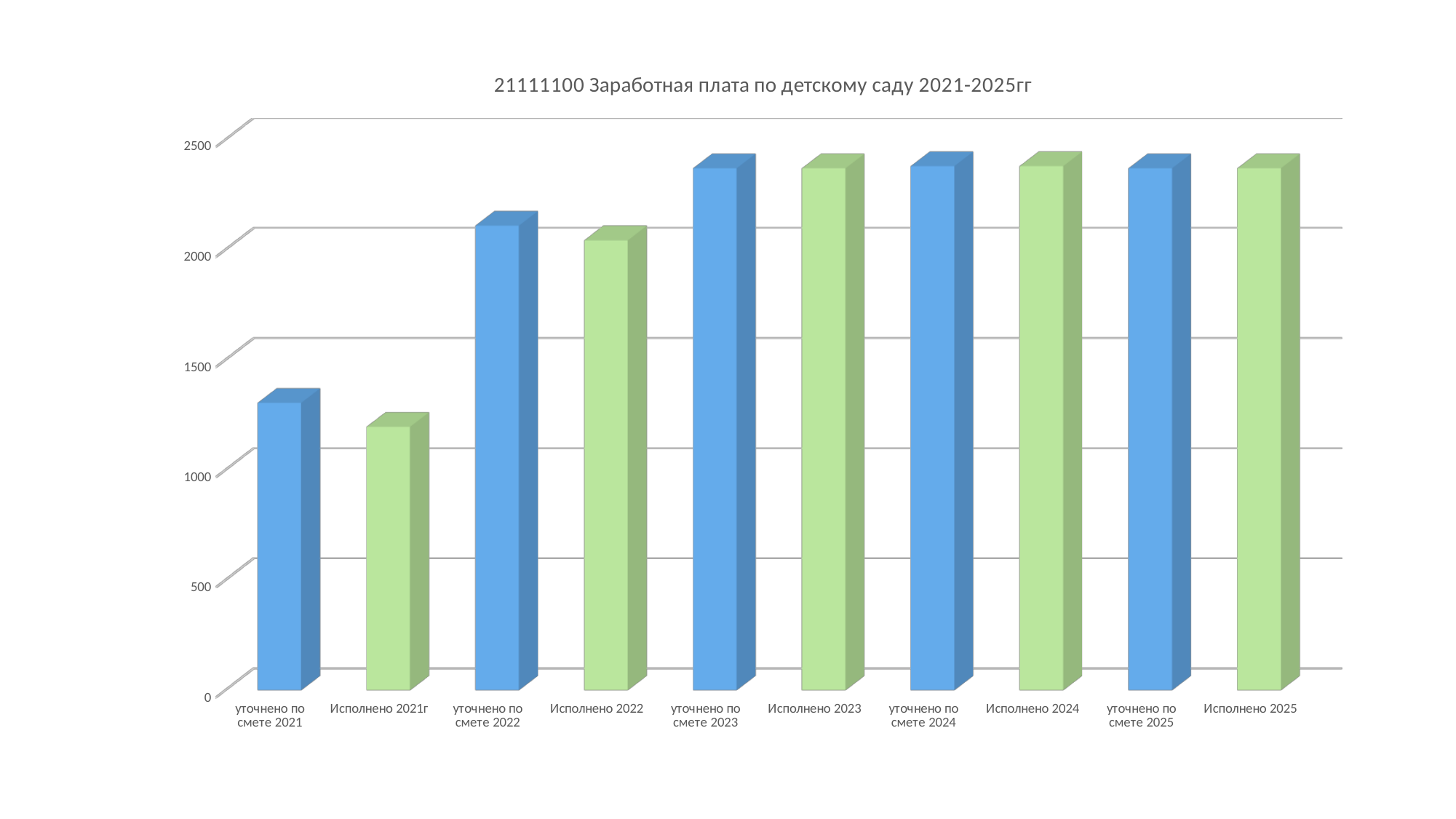
Do the values generally rise or fall from 2021 to 2025 along the x axis? rise Is the value for "Исполнено 2021г" greater or less than 1000? greater Which is larger: the value for "уточнено по смете 2021" or "Исполнено 2021г"? уточнено по смете 2021 Is the value for "уточнено по смете 2021" greater or less than 1500? less How many bars (categories) are shown in the chart? 10 What is the title of the chart? 21111100 Заработная плата по детскому саду 2021-2025гг Is the value for "уточнено по смете 2022" greater or less than 2000? greater Which is larger: the value for "уточнено по смете 2022" or "Исполнено 2022"? уточнено по смете 2022 Which category has the lowest value in the chart? Исполнено 2021г What kind of chart is shown on the slide? bar chart